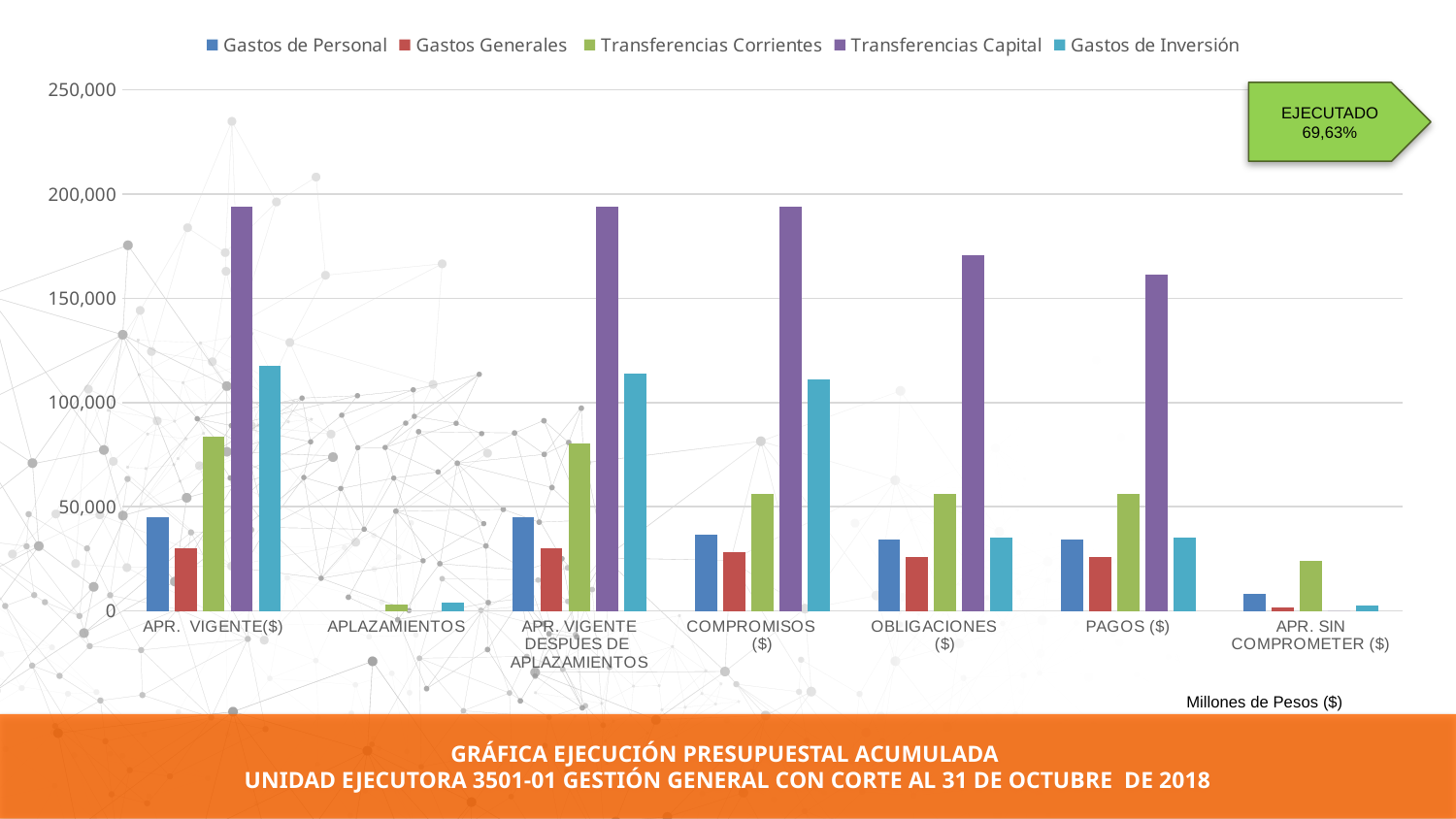
Is the value of Transferencias Capital for APR. VIGENTE($) greater or less than 150,000? greater Which series has the highest value in the APR. VIGENTE($) category? Transferencias Capital How many series does the legend list? 5 Is the value of Gastos de Inversión for APR. VIGENTE($) greater or less than 100,000? greater How many categories are shown along the x axis? 7 Is the value of Transferencias Capital for PAGOS ($) greater or less than 150,000? greater In the PAGOS ($) category, which is larger: Gastos de Personal or Gastos Generales? Gastos de Personal What percentage is shown in the EJECUTADO label on the slide? 69,63% Which series has the lowest value in the APR. VIGENTE($) category? Gastos Generales What kind of chart is shown on the slide? bar chart Is Transferencias Corrientes larger for APR. VIGENTE($) or for COMPROMISOS ($)? APR. VIGENTE($)